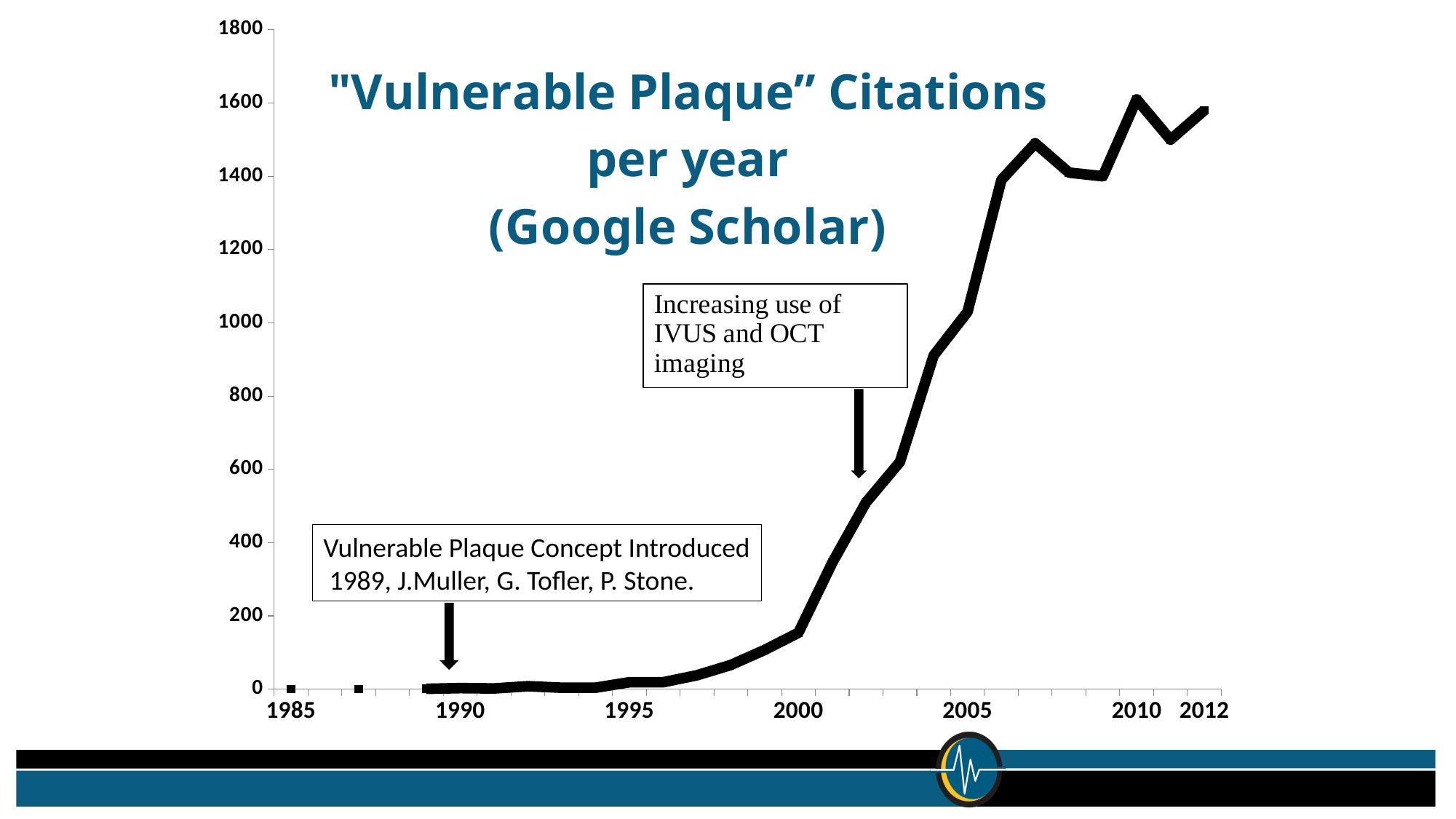
Is the number of citations in 2010 greater or less than 1400? greater What kind of chart is shown on the slide? line chart Is the number of citations in 2000 greater or less than 200? less Overall, do citations per year rise or fall from 1985 to 2012? rise What is the title of the chart? "Vulnerable Plaque" Citations per year (Google Scholar) Is the number of citations in 1995 greater or less than 200? less What is the highest value shown on the y axis? 1800 Which year has more citations, 2009 or 2010? 2010 Which year has more citations, 2000 or 2005? 2005 What is the last year labeled on the x axis? 2012